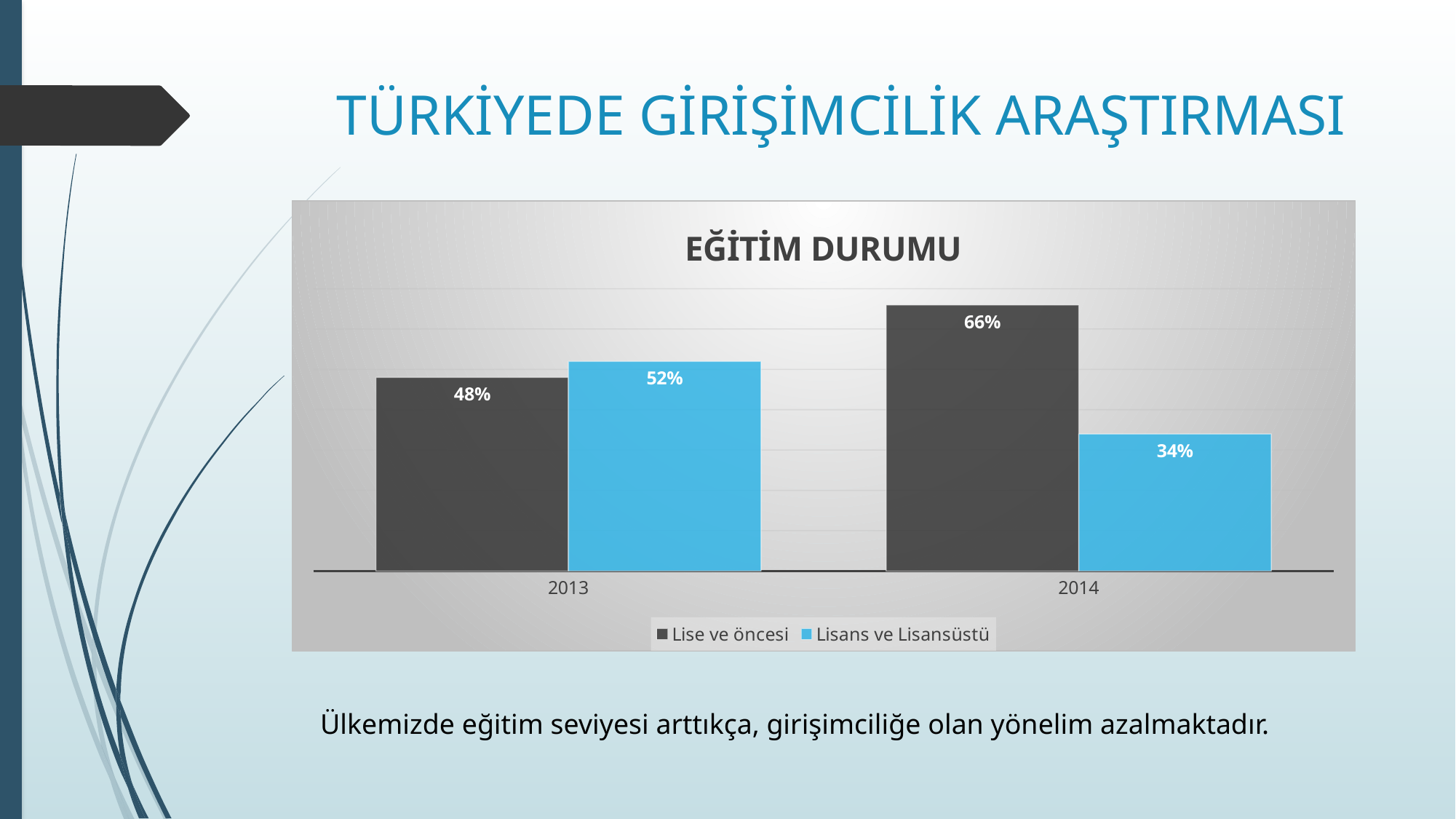
How many categories are shown on the x axis? 2 What is the difference between Lise ve öncesi and Lisans ve Lisansüstü in 2014? 32% What kind of chart is shown? Bar chart What is the value for Lisans ve Lisansüstü in 2013? 52% Which series has the lowest value in 2014? Lisans ve Lisansüstü Which series has the highest value in 2014? Lise ve öncesi What is the value for Lisans ve Lisansüstü in 2014? 34% What is the title of the chart? EĞİTİM DURUMU What is the value for Lise ve öncesi in 2014? 66% What is the value for Lise ve öncesi in 2013? 48% Which is larger in 2013, Lise ve öncesi or Lisans ve Lisansüstü? Lisans ve Lisansüstü How many series does the legend list? 2